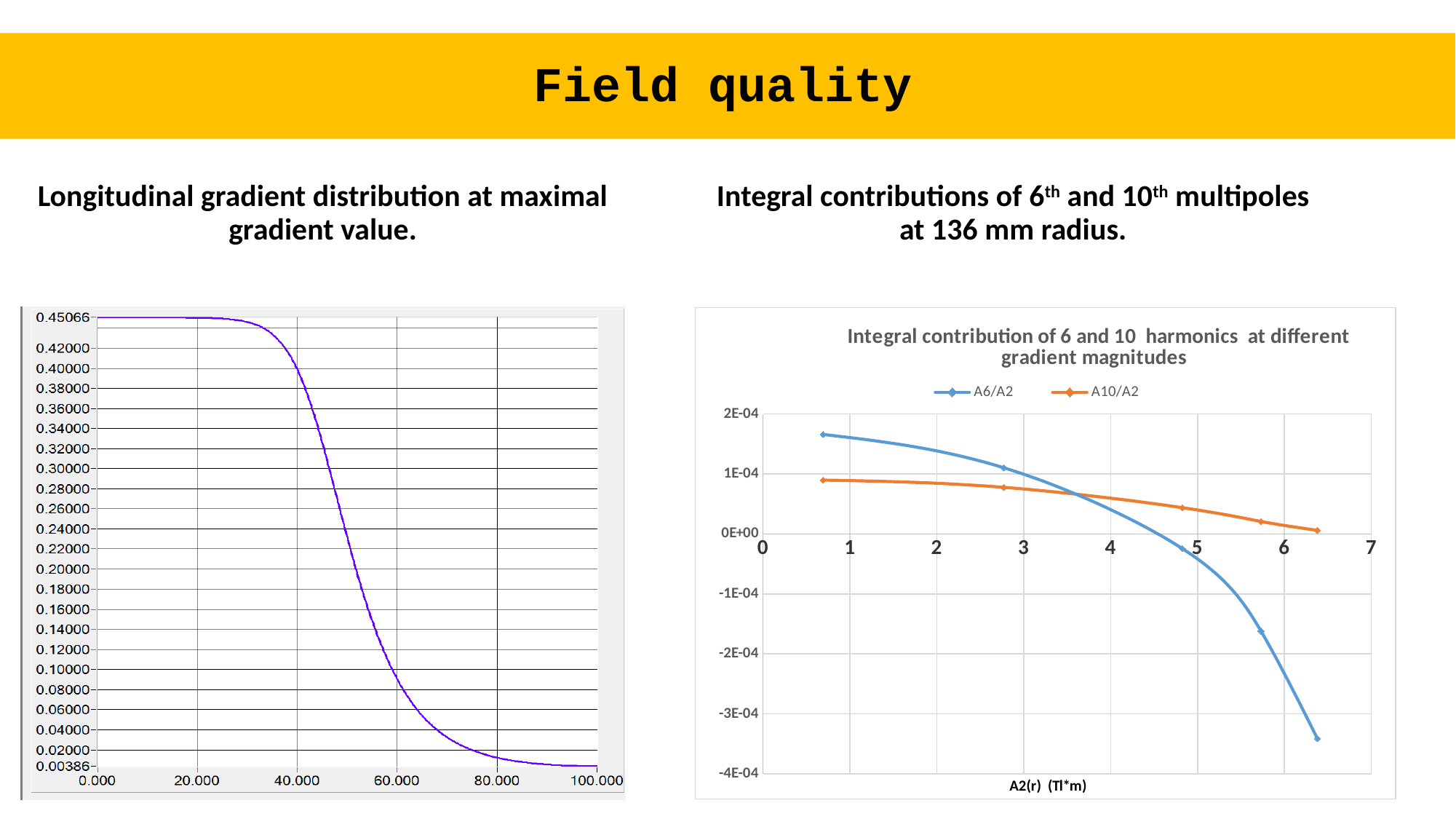
In the right chart (Integral contribution of 6 and 10 harmonics), is the value of A6/A2 at its rightmost data point greater or less than -3E-04? less In the right chart (Integral contribution of 6 and 10 harmonics), which series has the higher value at the rightmost data point (near A2(r) = 6.4)? A10/A2 How many series does the legend of the right chart (Integral contribution of 6 and 10 harmonics) list? 2 In the right chart (Integral contribution of 6 and 10 harmonics), does the A6/A2 series rise or fall as A2(r) increases? fall In the left chart (Longitudinal gradient distribution), do the values rise or fall as the x axis increases? fall What are the legend entries in the right chart (Integral contribution of 6 and 10 harmonics)? A6/A2 and A10/A2 What kind of chart is the left chart (Longitudinal gradient distribution)? line chart In the right chart (Integral contribution of 6 and 10 harmonics), how many data points are plotted for the A6/A2 series? 5 In the left chart (Longitudinal gradient distribution), what is the highest value printed on the y axis? 0.45066 In the left chart (Longitudinal gradient distribution), is the value at x = 20.000 greater or less than 0.40000? greater What kind of chart is the right chart (Integral contribution of 6 and 10 harmonics)? line chart In the left chart (Longitudinal gradient distribution), is the value at x = 80.000 greater or less than 0.04000? less